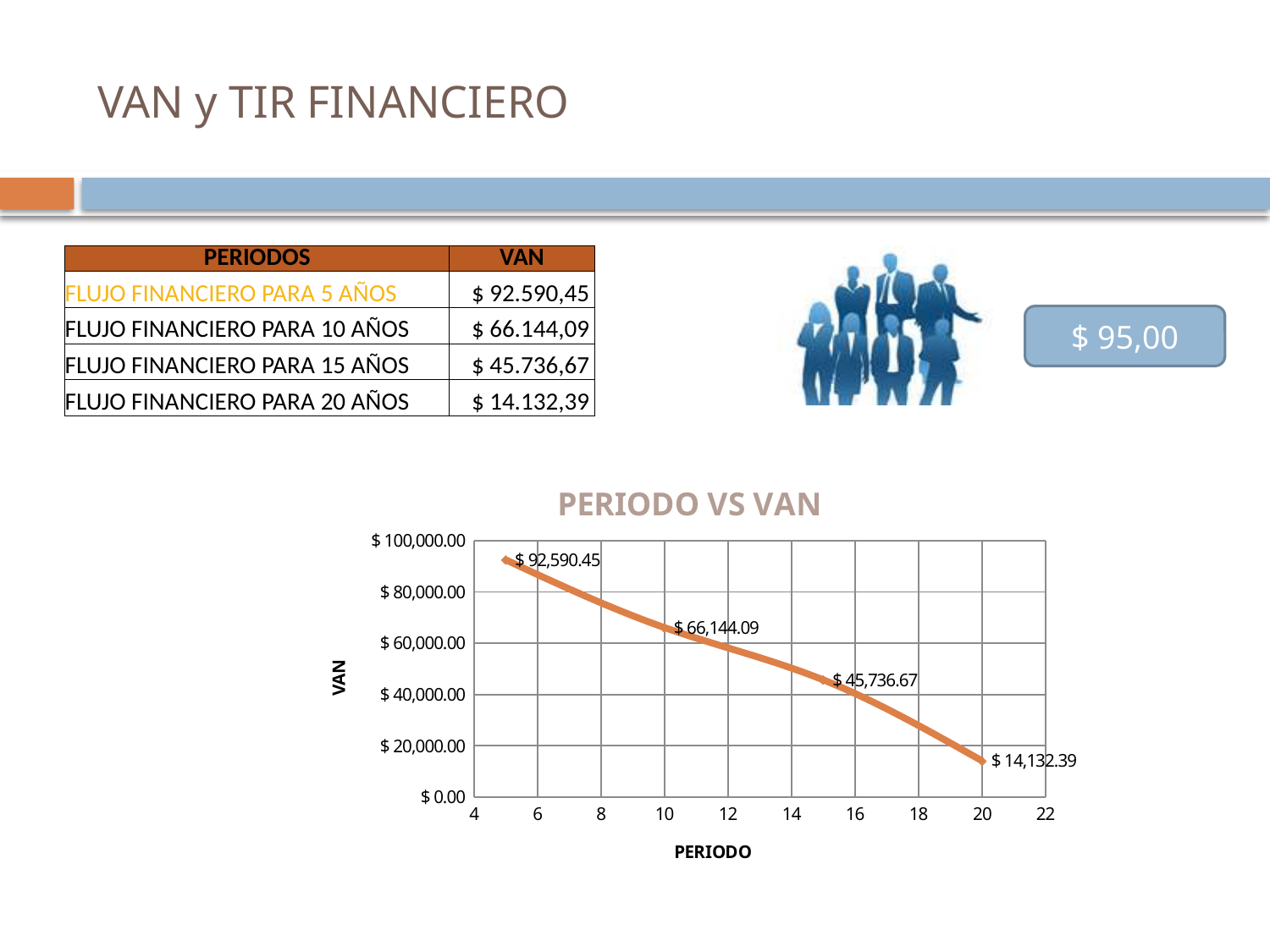
In the PERIODO VS VAN chart, which period has the lowest VAN? 20 What type of chart is shown under the title PERIODO VS VAN? line chart In the PERIODO VS VAN chart, does the VAN rise or fall as the period increases? fall In the PERIODO VS VAN chart, what is the difference between the VAN at period 15 and the VAN at period 20? $ 31,604.28 In the PERIODO VS VAN chart, what is the VAN value at period 20? $ 14,132.39 In the PERIODO VS VAN chart, how many data points are labelled on the line? 4 In the PERIODO VS VAN chart, is the VAN at period 10 larger or smaller than the VAN at period 15? larger In the PERIODO VS VAN chart, what is the VAN value at period 5? $ 92,590.45 In the PERIODO VS VAN chart, what is the VAN value at period 10? $ 66,144.09 In the PERIODO VS VAN chart, which period has the highest VAN? 5 In the PERIODO VS VAN chart, what is the VAN value at period 15? $ 45,736.67 In the PERIODO VS VAN chart, what is the difference between the VAN at period 5 and the VAN at period 10? $ 26,446.36